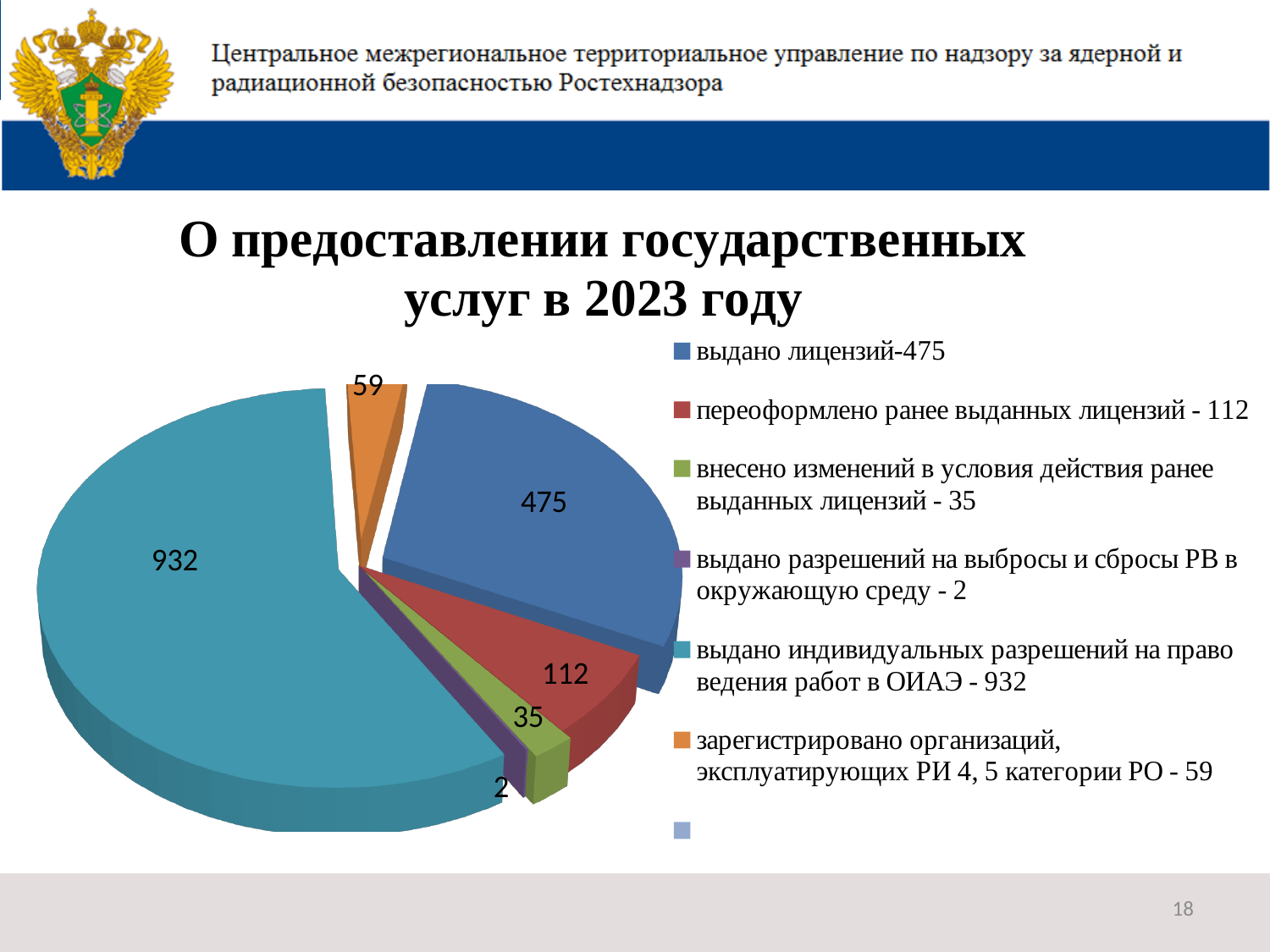
What is the value for "выдано индивидуальных разрешений на право ведения работ в ОИАЭ"? 932 What is the total of all the values shown on the pie chart? 1615 What is the value for "выдано лицензий"? 475 What is the title of the slide containing the pie chart? О предоставлении государственных услуг в 2023 году What type of chart is shown on the slide? pie chart Which category has the smallest slice of the pie? выдано разрешений на выбросы и сбросы РВ в окружающую среду What is the value for "переоформлено ранее выданных лицензий"? 112 Which category has the largest slice of the pie? выдано индивидуальных разрешений на право ведения работ в ОИАЭ What is the difference between the value for "выдано лицензий" and the value for "переоформлено ранее выданных лицензий"? 363 How many slices does the pie chart have? 6 What is the value for "зарегистрировано организаций, эксплуатирующих РИ 4, 5 категории РО"? 59 Which is larger: the value for "внесено изменений в условия действия ранее выданных лицензий" or the value for "зарегистрировано организаций, эксплуатирующих РИ 4, 5 категории РО"? зарегистрировано организаций, эксплуатирующих РИ 4, 5 категории РО